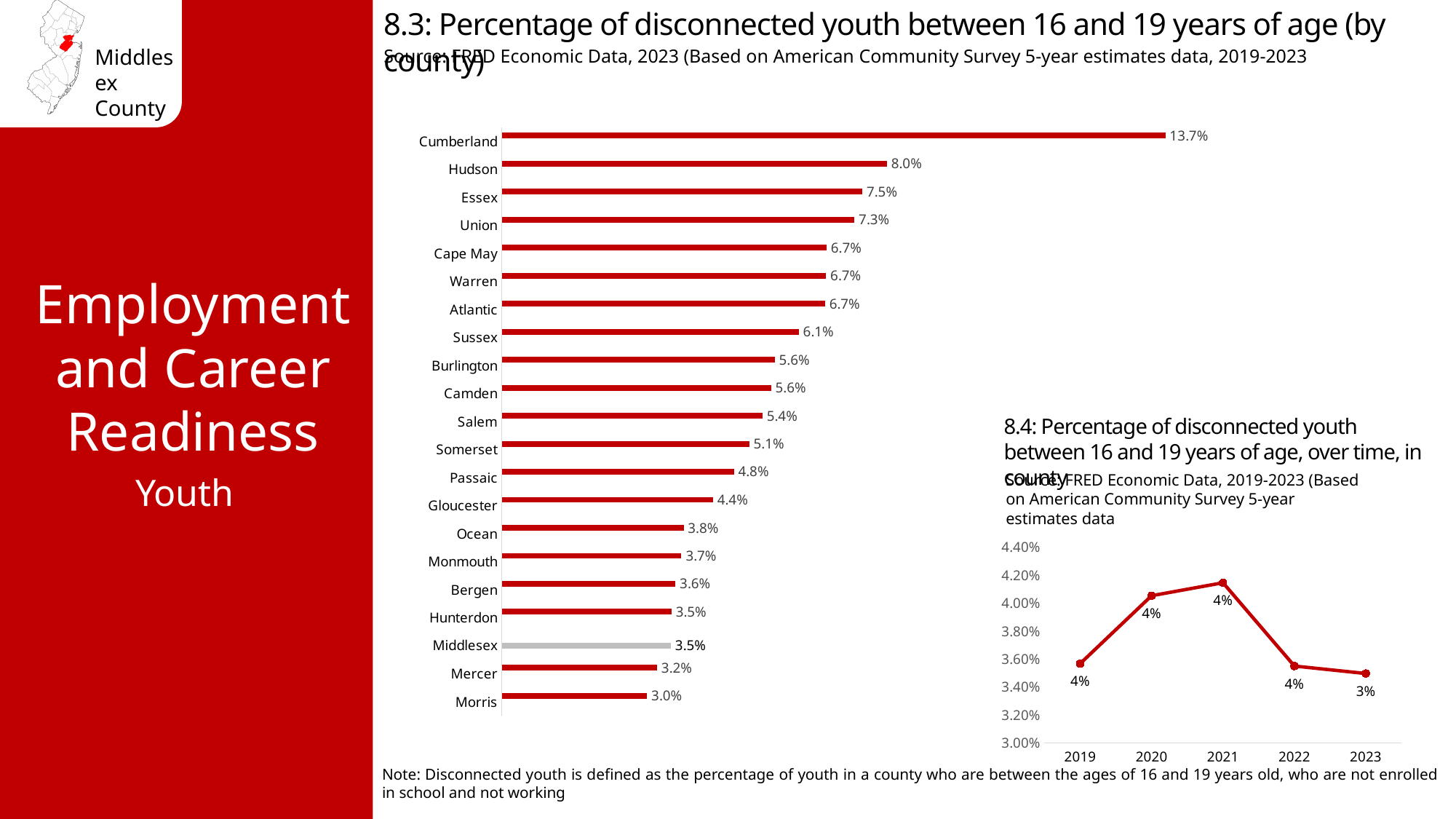
In chart 8.3, which county has the highest percentage of disconnected youth? Cumberland In chart 8.3, what is the value shown for Middlesex? 3.5% What type of chart is chart 8.3? Bar chart In chart 8.4, is the value for 2019 greater or less than 3.80%? less How many counties are shown in chart 8.3? 21 In chart 8.4, do the values rise or fall from 2021 to 2023? fall In chart 8.3, what is the difference between Hudson's value and Middlesex's value? 4.5% In chart 8.4, is the value for 2021 greater or less than 4.00%? greater In chart 8.3, which bar is coloured grey instead of red? Middlesex In chart 8.3, which county has a higher value, Passaic or Gloucester? Passaic In chart 8.3, what is the percentage of disconnected youth for Cumberland? 13.7% In chart 8.3, which county has the lowest percentage of disconnected youth? Morris